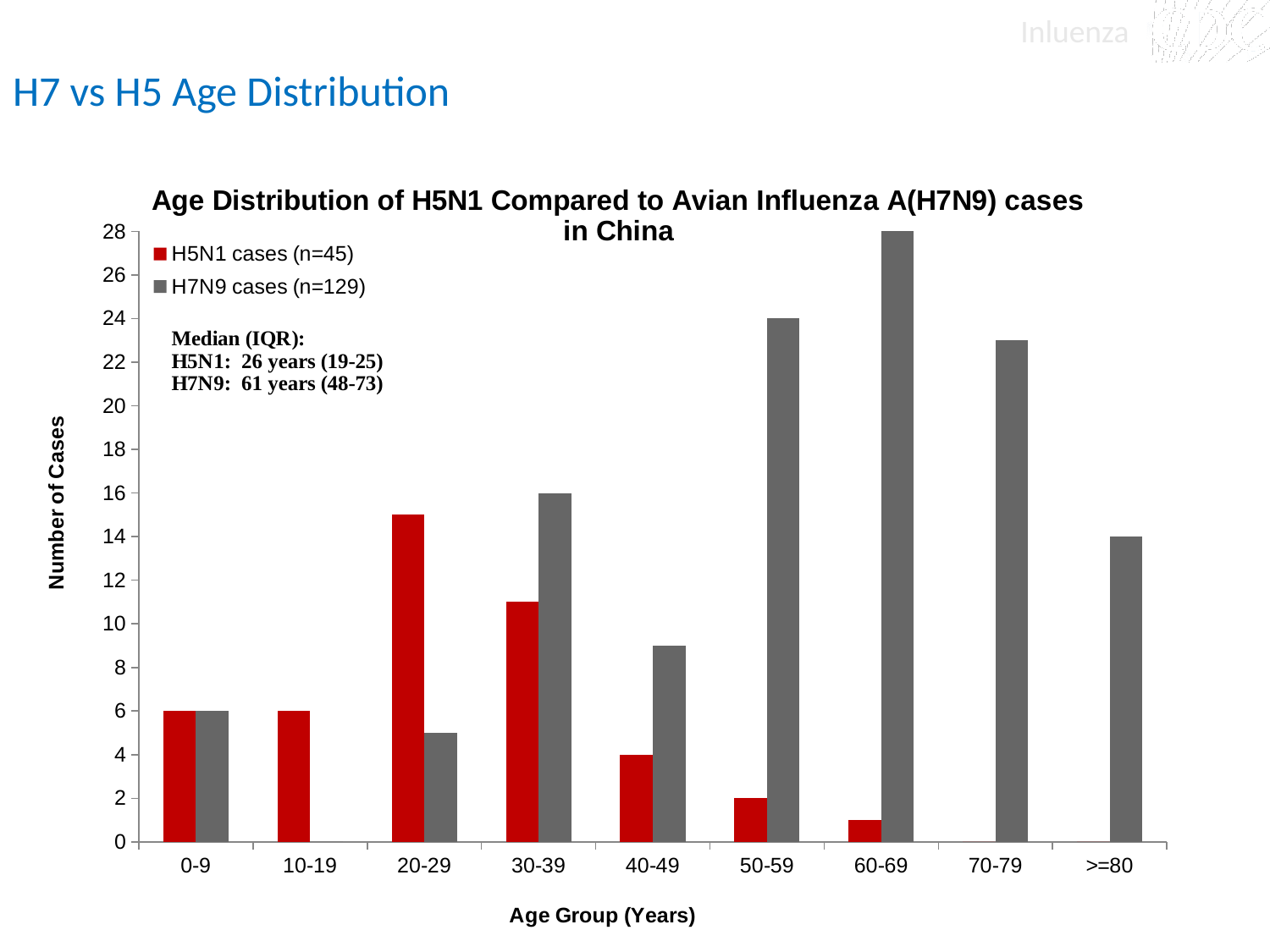
In the 30-39 age group, which series has more cases, H5N1 or H7N9? H7N9 Is the number of H5N1 cases in the 20-29 age group greater or less than 14? greater What kind of chart is shown on the slide? bar chart What is the number of H7N9 cases in the >=80 age group? 14 What is the number of H5N1 cases in the 0-9 age group? 6 Which age group has the highest number of H7N9 cases? 60-69 What is the number of H7N9 cases in the 50-59 age group? 24 Which age group has the highest number of H5N1 cases? 20-29 How many age groups are shown on the x axis? 9 How many series does the legend list? 2